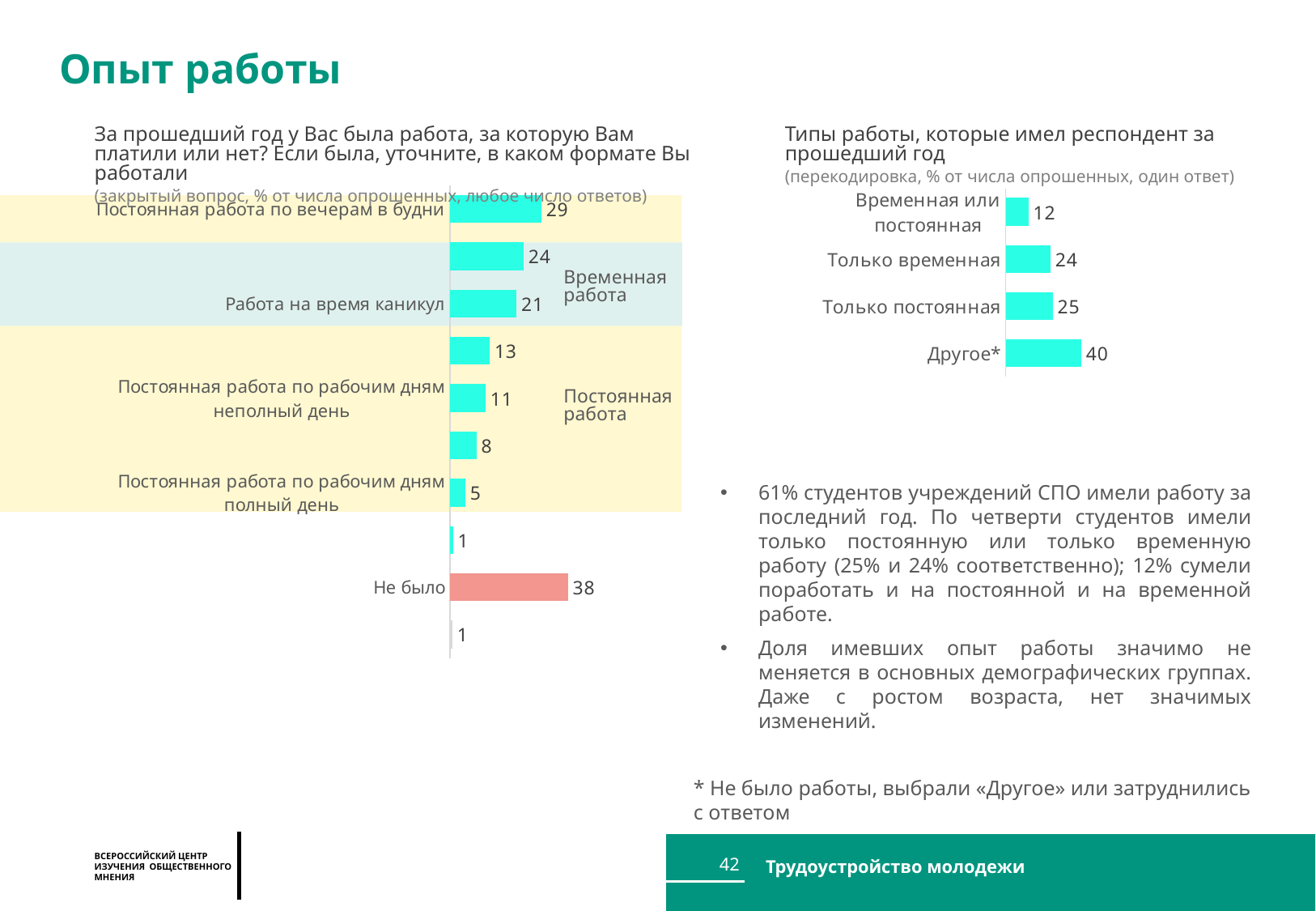
In the left chart about work over the past year, what is the value for "Работа на время каникул"? 21 In the chart titled "Типы работы, которые имел респондент за прошедший год", which category has the lowest value? Временная или постоянная In the left chart about work over the past year, what is the value for "Не было"? 38 In the left chart about work over the past year, what is the difference between "Не было" and "Постоянная работа по вечерам в будни"? 9 What type of chart is the left chart about work over the past year? Bar chart In the chart titled "Типы работы, которые имел респондент за прошедший год", what is the value for "Только постоянная"? 25 In the chart titled "Типы работы, которые имел респондент за прошедший год", what is the difference between "Только постоянная" and "Только временная"? 1 In the chart titled "Типы работы, которые имел респондент за прошедший год", which is larger: "Другое*" or "Только временная"? Другое* In the left chart about work over the past year, what is the value for "Постоянная работа по вечерам в будни"? 29 In the chart titled "Типы работы, которые имел респондент за прошедший год", what is the value for "Временная или постоянная"? 12 In the chart titled "Типы работы, которые имел респондент за прошедший год", which category has the highest value? Другое* How many categories are shown in the chart titled "Типы работы, которые имел респондент за прошедший год"? 4